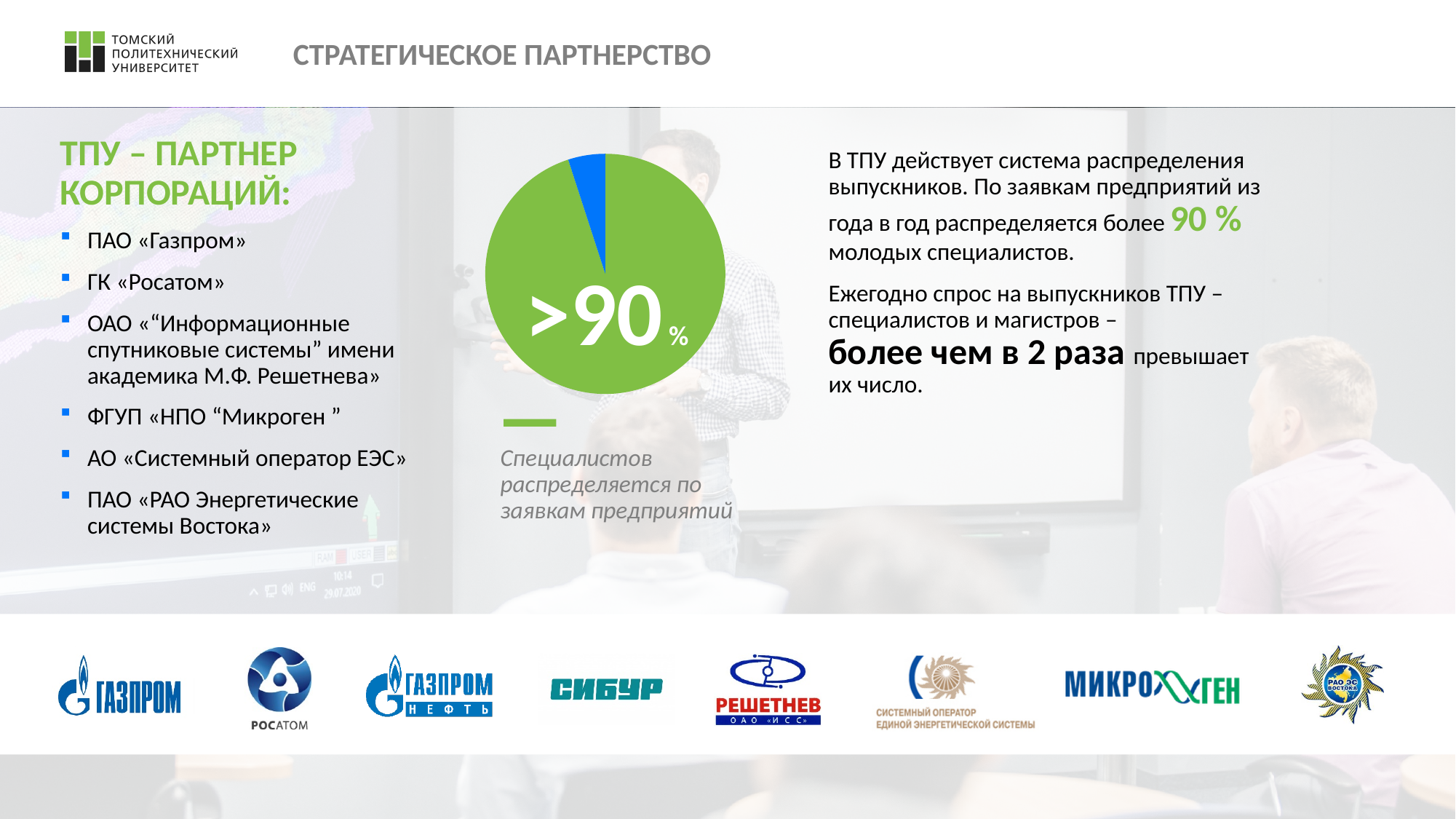
Which slice of the pie chart is the smallest? the blue slice What does the green slice of the pie chart represent, according to the caption below it? Специалистов распределяется по заявкам предприятий What colour is the slice of the pie chart labelled >90%? green How many slices does the pie chart have? 2 What value is printed on the pie chart? >90% What kind of chart is shown on the slide? pie chart Which slice of the pie chart is larger, the green one or the blue one? the green one What share of the pie does the green slice represent, as printed on the chart? >90% Is the share of the green slice in the pie chart greater or less than 50%? greater